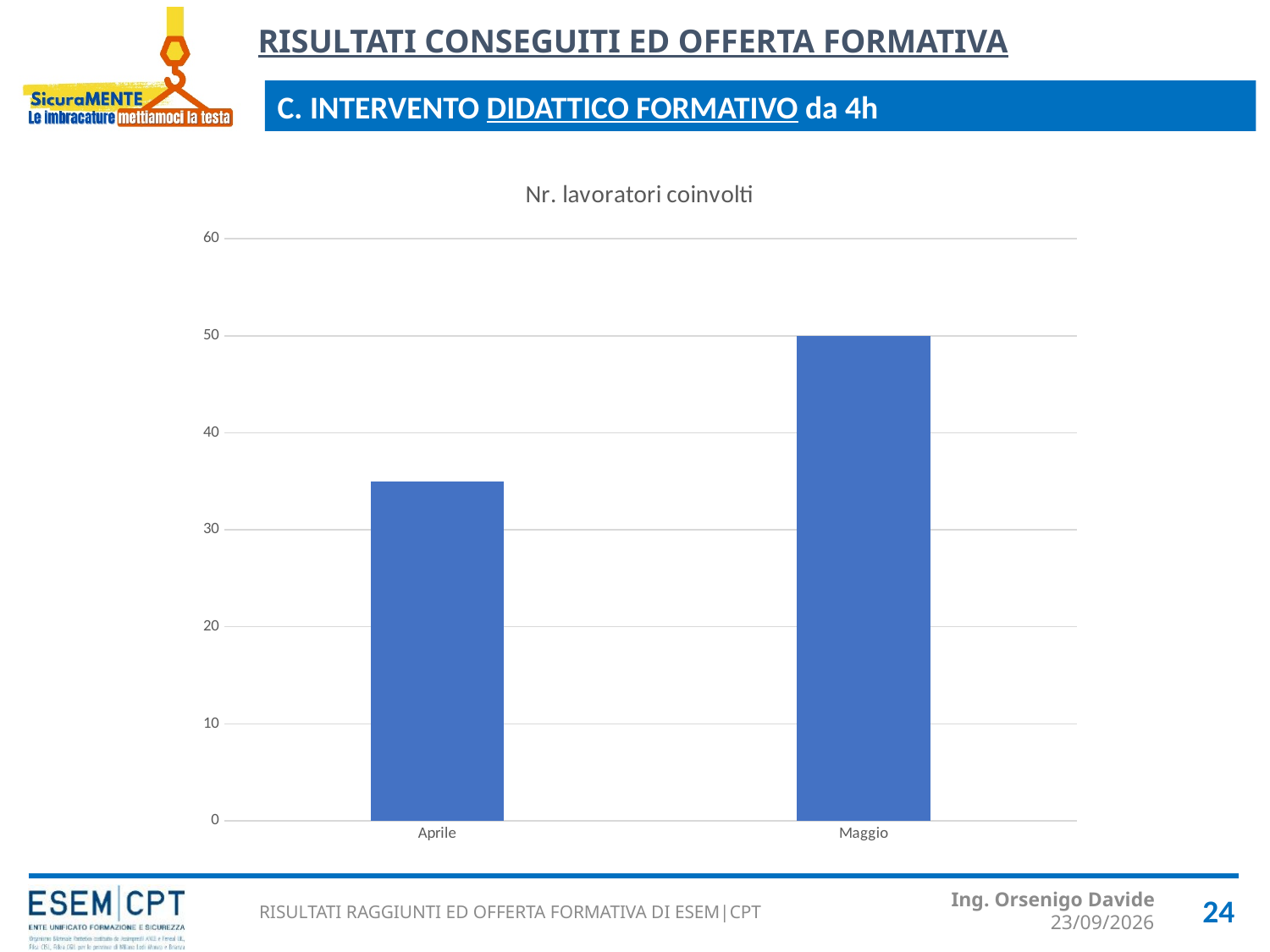
Is the value for Maggio greater or less than 40? greater Do the values rise or fall from Aprile to Maggio? rise What colour are the bars in the chart? blue How many categories are shown on the x axis of the chart? 2 Which category has the highest value in the chart? Maggio Is the value for Aprile greater or less than 30? greater What kind of chart is shown on the slide? bar chart Which category has the lowest value in the chart? Aprile What is the title of the chart? Nr. lavoratori coinvolti Is the value for Aprile greater or less than 40? less Which is larger, the value for Aprile or the value for Maggio? Maggio What is the value for Maggio in the chart? 50